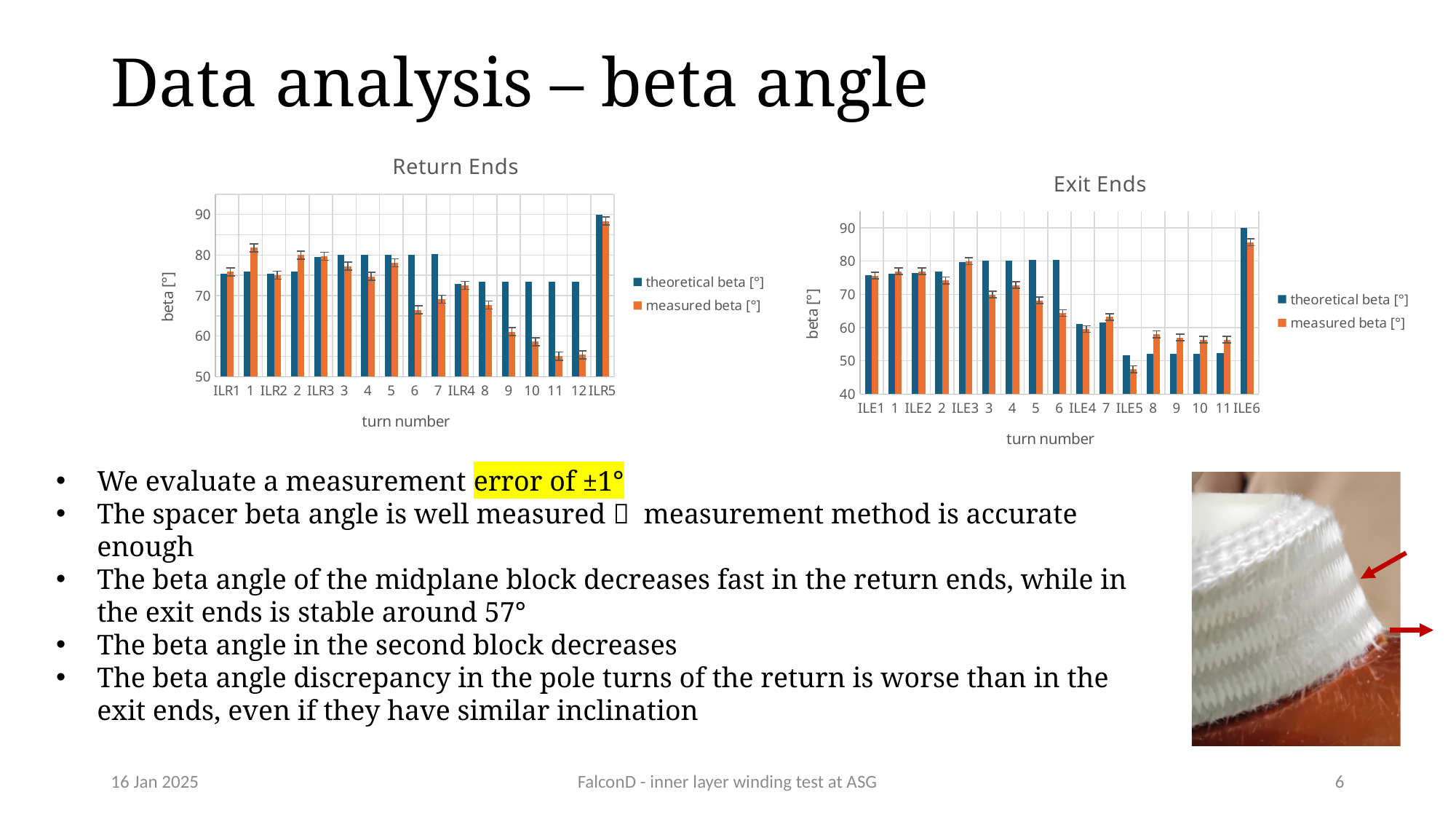
In the Exit Ends chart, for turn 8, which is larger: the theoretical beta or the measured beta? measured beta In the Exit Ends chart, which turn number has the lowest measured beta? ILE5 In the Return Ends chart, does the measured beta rise or fall from turn 8 to turn 12? fall In the Return Ends chart, which turn number has the highest theoretical beta? ILR5 How many turn-number categories are shown on the x axis of the Return Ends chart? 17 In the Exit Ends chart, which turn number has the highest measured beta? ILE6 In the Return Ends chart, is the measured beta for turn 1 greater or less than 80? greater How many series does the legend of the Exit Ends chart list? 2 What type of chart is the Return Ends chart? bar chart In the Return Ends chart, for turn 6, which is larger: the theoretical beta or the measured beta? theoretical beta In the Return Ends chart, is the measured beta for turn 11 greater or less than 60? less In the Exit Ends chart, is the measured beta for ILE5 greater or less than 50? less